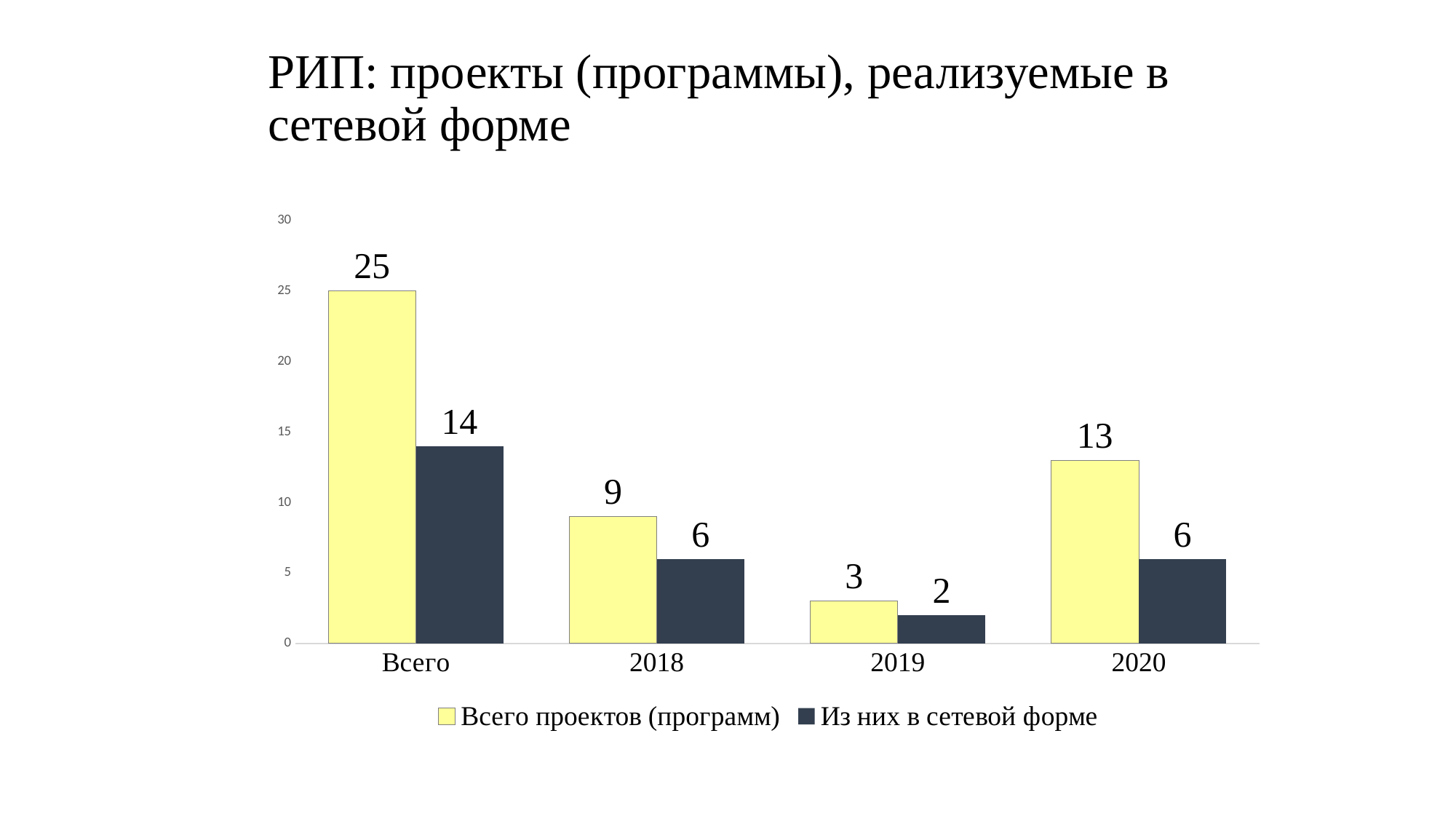
What is the difference between 'Всего проектов (программ)' and 'Из них в сетевой форме' for 'Всего'? 11 What is the value of 'Всего проектов (программ)' for 2020? 13 How many categories are shown on the x axis? 4 How many series does the legend list? 2 What is the value of 'Всего проектов (программ)' for 'Всего'? 25 Which is larger: 'Из них в сетевой форме' for 2018 or for 2019? 2018 What is the value of 'Из них в сетевой форме' for 2019? 2 Which year (2018, 2019 or 2020) has the lowest value for 'Всего проектов (программ)'? 2019 What is the value of 'Из них в сетевой форме' for 2018? 6 Which year (2018, 2019 or 2020) has the highest value for 'Всего проектов (программ)'? 2020 What is the difference between 'Всего проектов (программ)' for 2020 and for 2018? 4 What kind of chart is shown on the slide? Bar chart